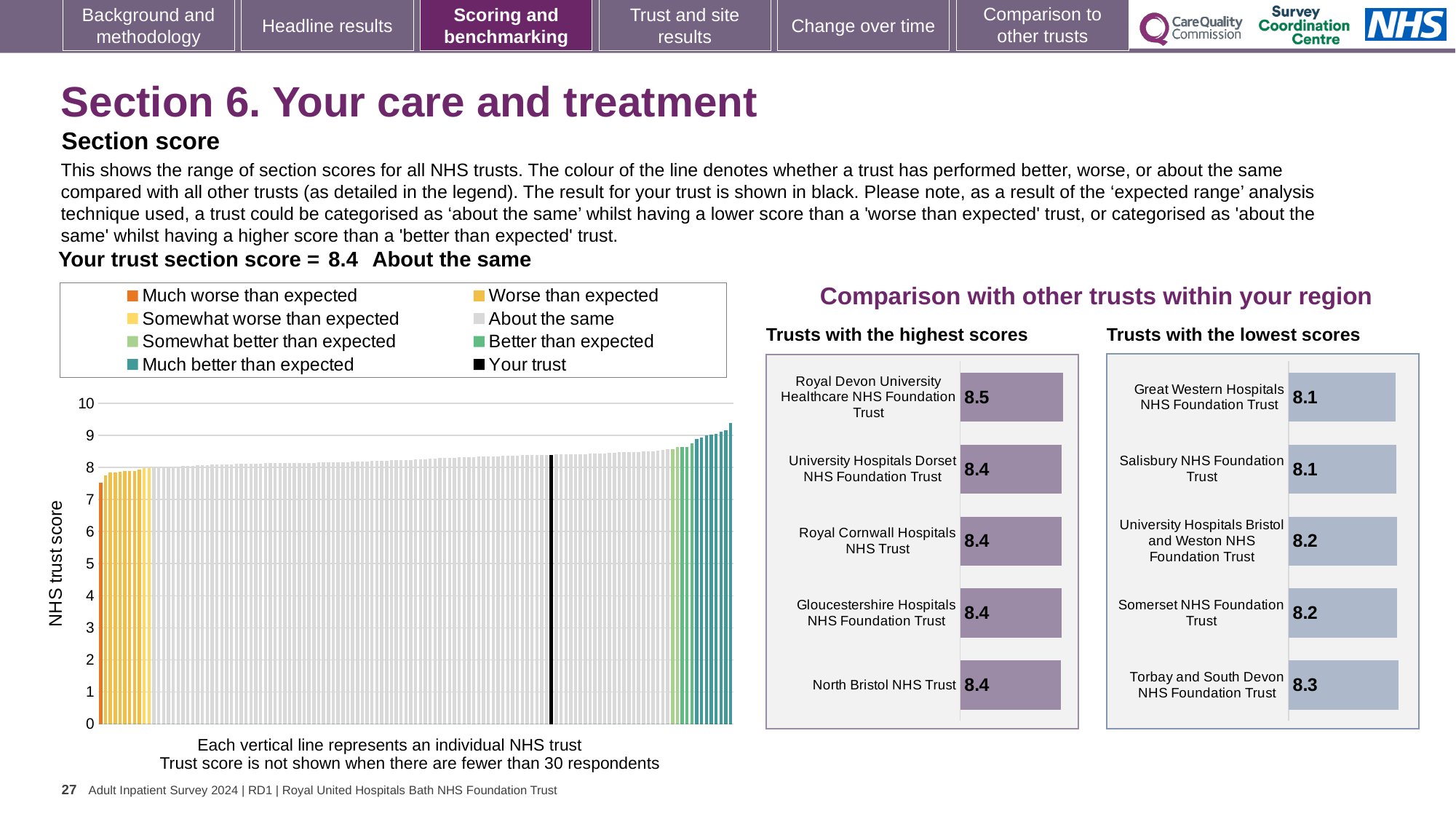
In the 'Trusts with the highest scores' chart, what is the score for Royal Devon University Healthcare NHS Foundation Trust? 8.5 In the 'Trusts with the highest scores' chart, which trust has the highest score? Royal Devon University Healthcare NHS Foundation Trust How many trusts are listed in the 'Trusts with the highest scores' chart? 5 In the large NHS trust score chart, do the values rise or fall from left to right along the x axis? Rise How many entries does the legend of the NHS trust score chart list? 8 In the 'Trusts with the lowest scores' chart, what is the score for Torbay and South Devon NHS Foundation Trust? 8.3 In the 'Trusts with the highest scores' chart, what is the difference between the scores of Royal Devon University Healthcare NHS Foundation Trust and North Bristol NHS Trust? 0.1 What kind of chart is the large chart on the left showing NHS trust scores? Bar chart In the 'Trusts with the lowest scores' chart, which has the larger score: Torbay and South Devon NHS Foundation Trust or Somerset NHS Foundation Trust? Torbay and South Devon NHS Foundation Trust In the 'Trusts with the lowest scores' chart, which trust has the highest score? Torbay and South Devon NHS Foundation Trust What is the label on the y axis of the large NHS trust score chart? NHS trust score In the 'Trusts with the lowest scores' chart, what is the difference between the scores of Torbay and South Devon NHS Foundation Trust and Great Western Hospitals NHS Foundation Trust? 0.2